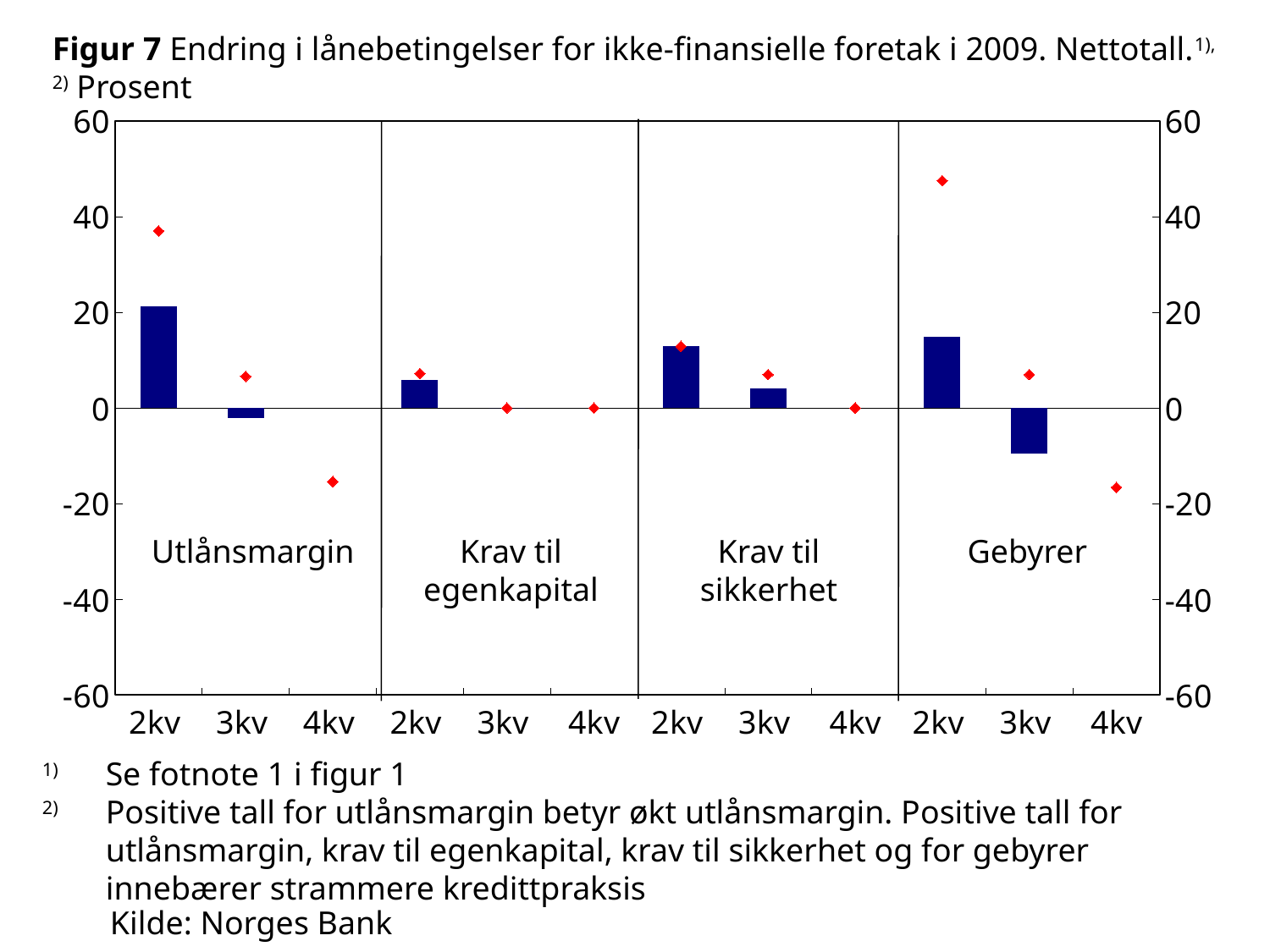
Which panel has the highest bar for 2kv? Utlånsmargin How many panels (loan condition categories) does the chart have? 4 Is the bar for 3kv in the Gebyrer panel greater or less than 0? less What kind of chart is shown in Figur 7? combination bar and line chart (bars with red diamond markers) Is the bar for 2kv in the Gebyrer panel greater or less than 20? less Is the red diamond marker for 2kv in the Gebyrer panel greater or less than 40? greater Which is larger, the 2kv bar for Krav til sikkerhet or the 2kv bar for Krav til egenkapital? Krav til sikkerhet Which panel has the lowest bar for 3kv? Gebyrer Do the bars in the Gebyrer panel rise or fall from 2kv to 3kv? fall How many quarters are shown on the x axis within each panel? 3